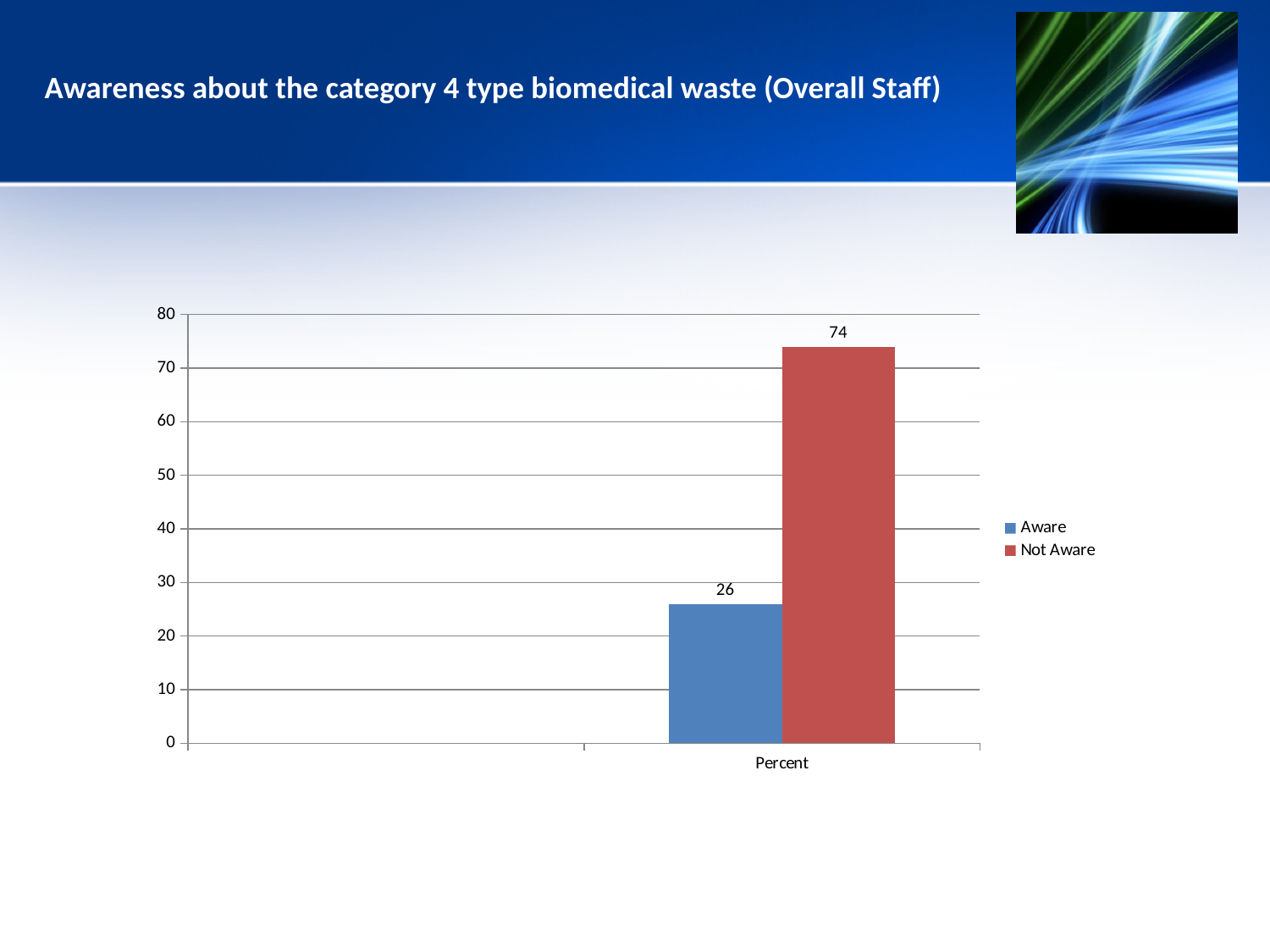
What colour is the bar for Not Aware? red What is the difference between the Not Aware and Aware values? 48 Which is larger, the value for Aware or the value for Not Aware? Not Aware How many series does the legend list? 2 What is the value for Aware? 26 What kind of chart is shown on the slide? bar chart Is the value for Aware greater or less than 30? less What is the value for Not Aware? 74 What is the label on the x axis under the bars? Percent Which series has the highest value? Not Aware Is the value for Not Aware greater or less than 70? greater Which series has the lowest value? Aware